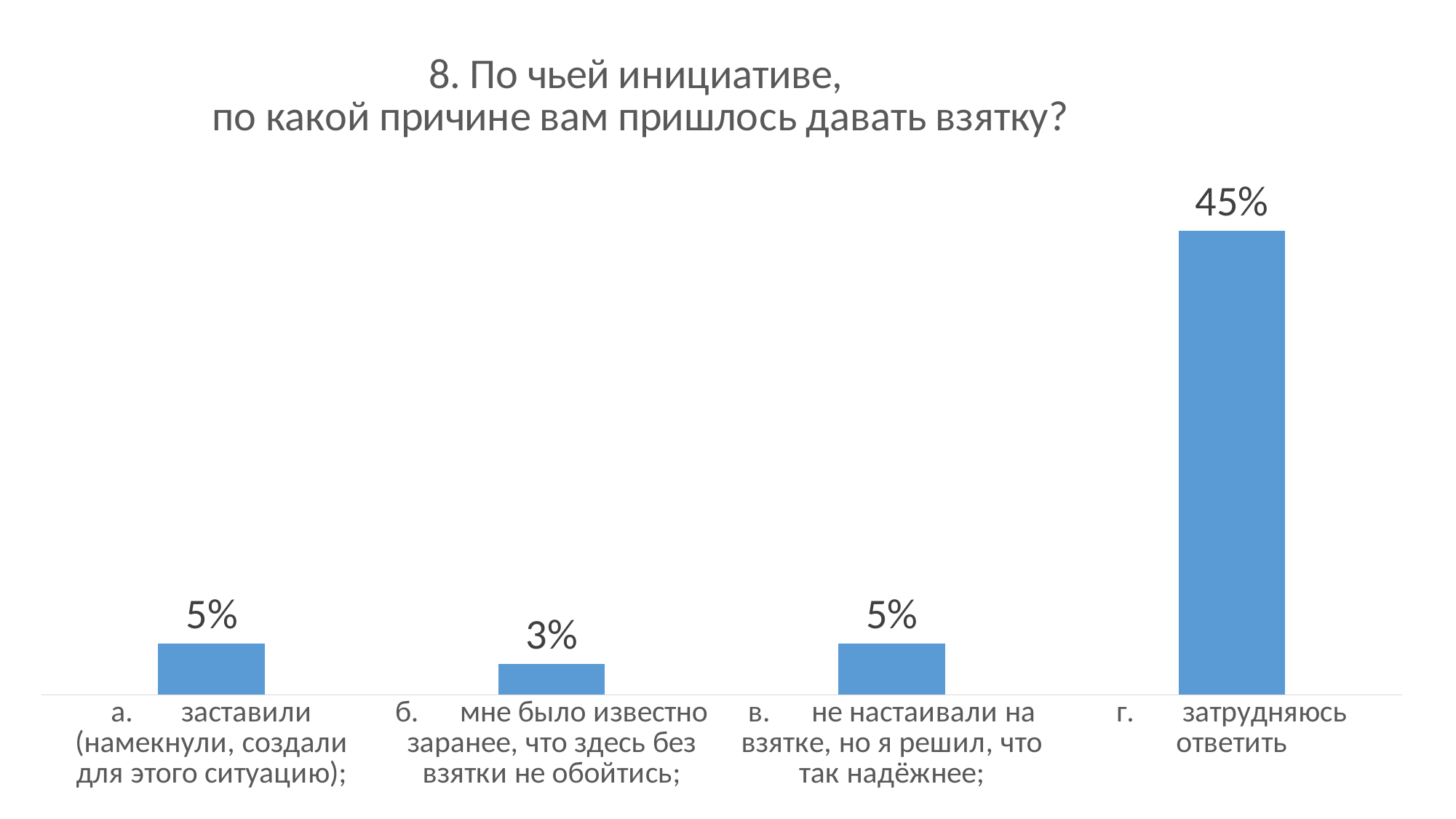
How many categories are shown on the chart? 4 What is the title of the chart? 8. По чьей инициативе, по какой причине вам пришлось давать взятку? What value is shown for the category "г. затрудняюсь ответить"? 45% What kind of chart is shown on the slide? Bar chart What is the difference between the value for "г. затрудняюсь ответить" and the value for "б. мне было известно заранее, что здесь без взятки не обойтись"? 42% What value is shown for the category "б. мне было известно заранее, что здесь без взятки не обойтись"? 3% Which category has the highest value? г. затрудняюсь ответить Which category has the lowest value? б. мне было известно заранее, что здесь без взятки не обойтись Which is larger: the value for "в. не настаивали на взятке, но я решил, что так надёжнее" or the value for "б. мне было известно заранее, что здесь без взятки не обойтись"? в. не настаивали на взятке, но я решил, что так надёжнее What value is shown for the category "в. не настаивали на взятке, но я решил, что так надёжнее"? 5% What is the difference between the value for "а. заставили" and the value for "б. мне было известно заранее"? 2% What value is shown for the category "а. заставили (намекнули, создали для этого ситуацию)"? 5%